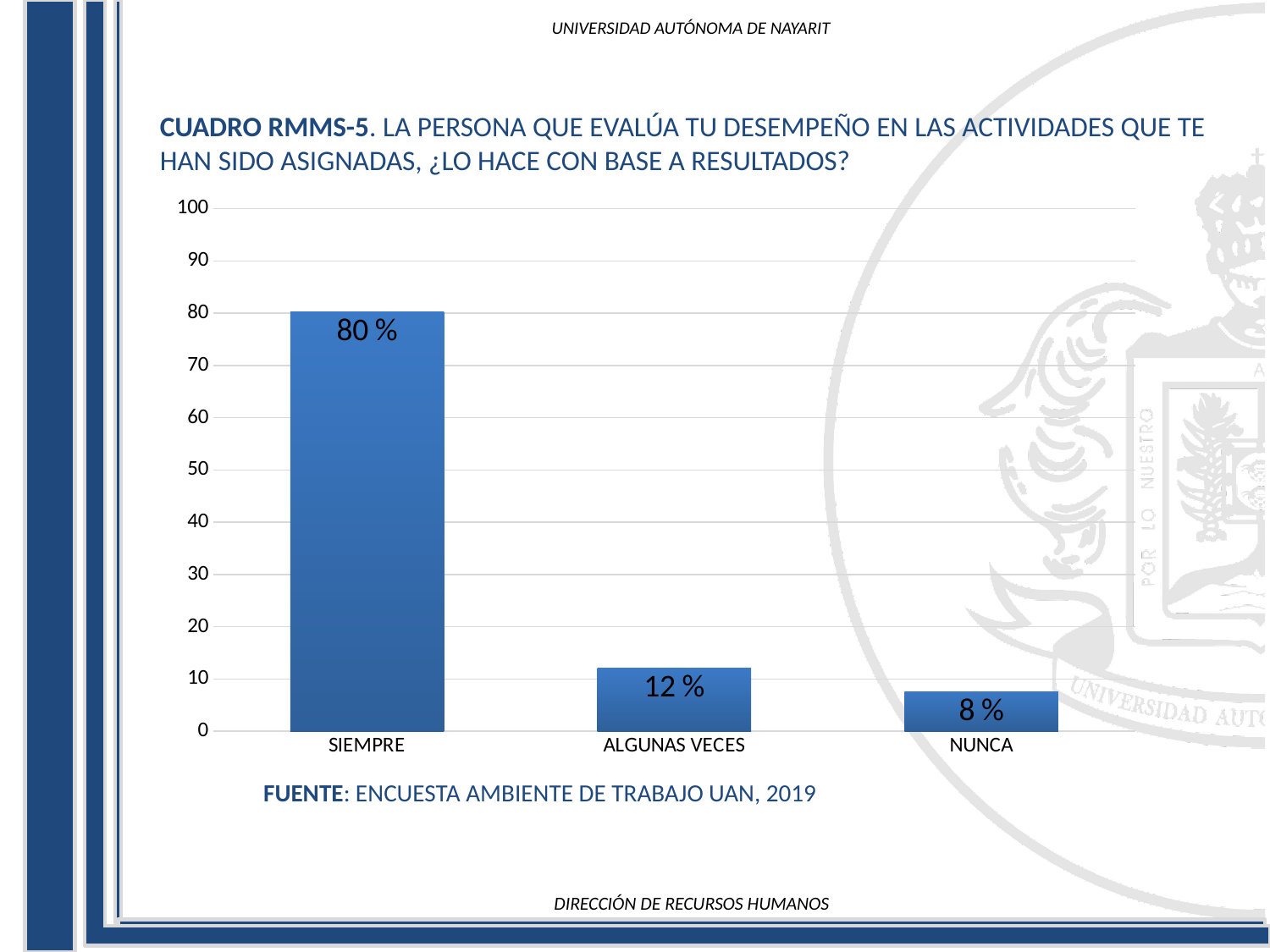
What is the value for SIEMPRE? 80 % Which category has the highest value? SIEMPRE Is the value for SIEMPRE greater or less than 50? greater What is the value for ALGUNAS VECES? 12 % How many categories are shown on the x axis? 3 What kind of chart is shown on the slide? bar chart What source is cited below the chart? ENCUESTA AMBIENTE DE TRABAJO UAN, 2019 What is the value for NUNCA? 8 % Which category has the lowest value? NUNCA What is the difference between the values for SIEMPRE and ALGUNAS VECES? 68 % Which is larger, the value for ALGUNAS VECES or the value for NUNCA? ALGUNAS VECES What is the difference between the values for ALGUNAS VECES and NUNCA? 4 %